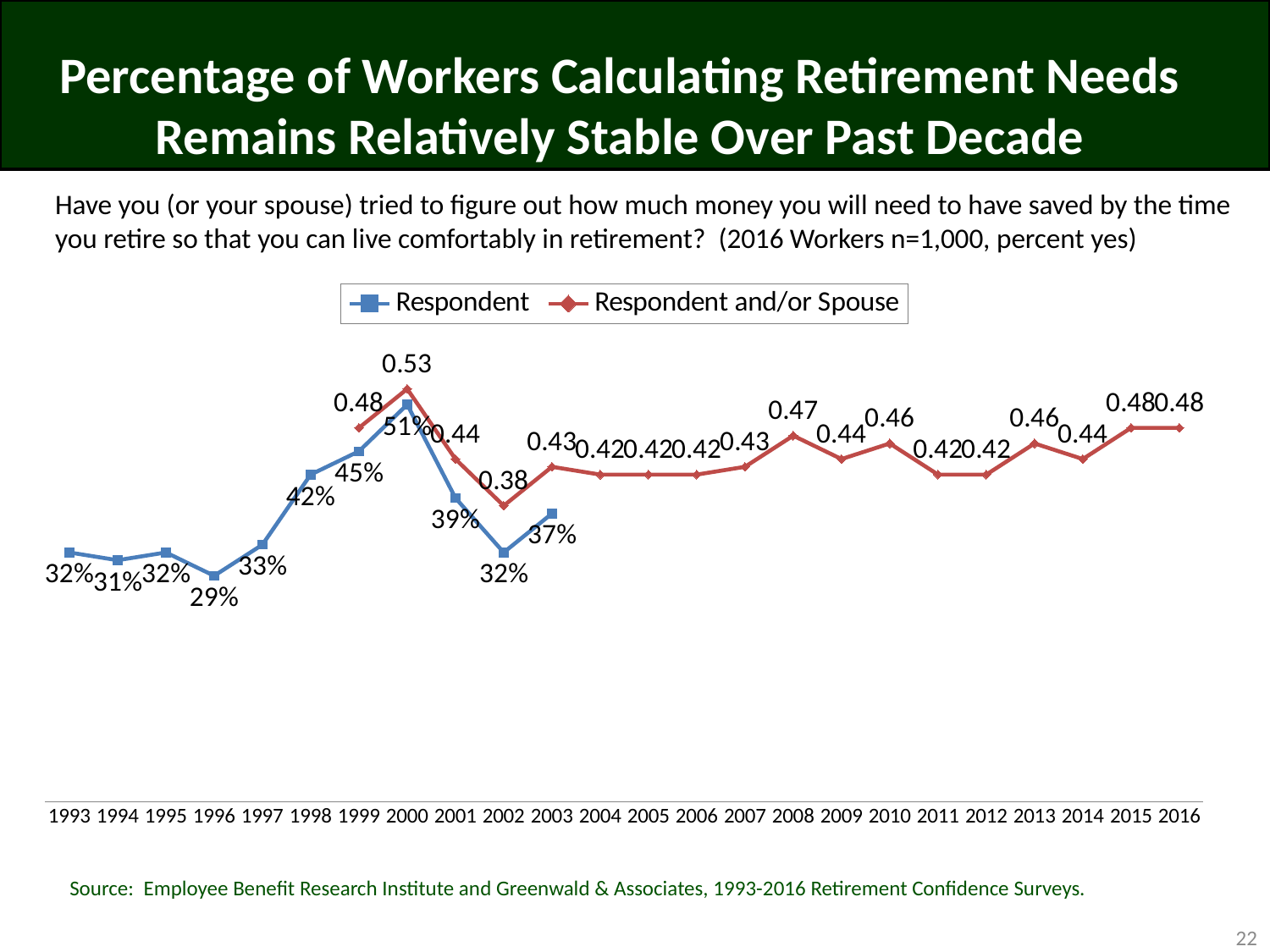
How many years are shown on the x axis? 24 What is the difference between the Respondent values for 2000 and 2002? 19 percentage points Does the Respondent series rise or fall from 1997 to 2000? Rise In which year is the Respondent and/or Spouse series at its highest? 2000 In which year is the Respondent series at its lowest? 1996 Which series is drawn in red? Respondent and/or Spouse Which is larger for the Respondent and/or Spouse series: the value in 2008 or the value in 2011? 2008 What is the value for the Respondent series in 2000? 51% How many series does the legend list? 2 What type of chart is shown on the slide? Line chart What is the value for the Respondent and/or Spouse series in 2002? 0.38 What is the value for the Respondent and/or Spouse series in 2016? 0.48